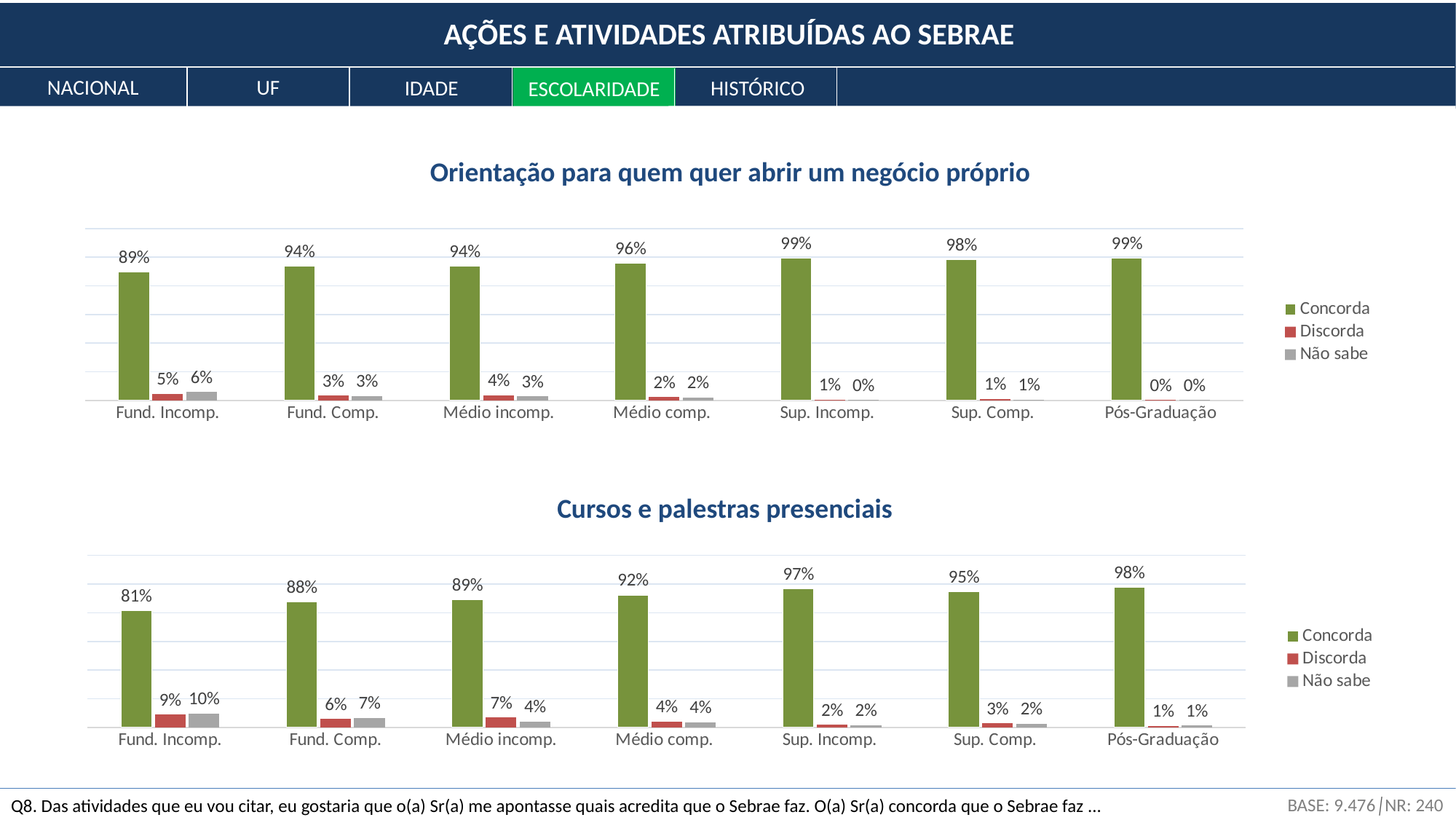
In the 'Orientação para quem quer abrir um negócio próprio' chart, what is the Não sabe value for Fund. Incomp.? 6% In the 'Cursos e palestras presenciais' chart, which category has the highest Concorda value? Pós-Graduação In the 'Orientação para quem quer abrir um negócio próprio' chart, which category has the lowest Concorda value? Fund. Incomp. In the 'Orientação para quem quer abrir um negócio próprio' chart, what is the difference between the Concorda values for Pós-Graduação and Fund. Incomp.? 10% What type of chart is the 'Cursos e palestras presenciais' chart? Bar chart In the 'Orientação para quem quer abrir um negócio próprio' chart, what is the Concorda value for Fund. Incomp.? 89% In the 'Cursos e palestras presenciais' chart, what is the Discorda value for Fund. Incomp.? 9% In the 'Cursos e palestras presenciais' chart, which is larger: the Concorda value for Sup. Incomp. or for Sup. Comp.? Sup. Incomp. How many categories are shown on the x axis of the 'Cursos e palestras presenciais' chart? 7 How many series does the legend of the 'Orientação para quem quer abrir um negócio próprio' chart list? 3 In the 'Cursos e palestras presenciais' chart, what is the Concorda value for Médio comp.? 92% In the 'Cursos e palestras presenciais' chart, what is the difference between the Não sabe values for Fund. Incomp. and Fund. Comp.? 3%